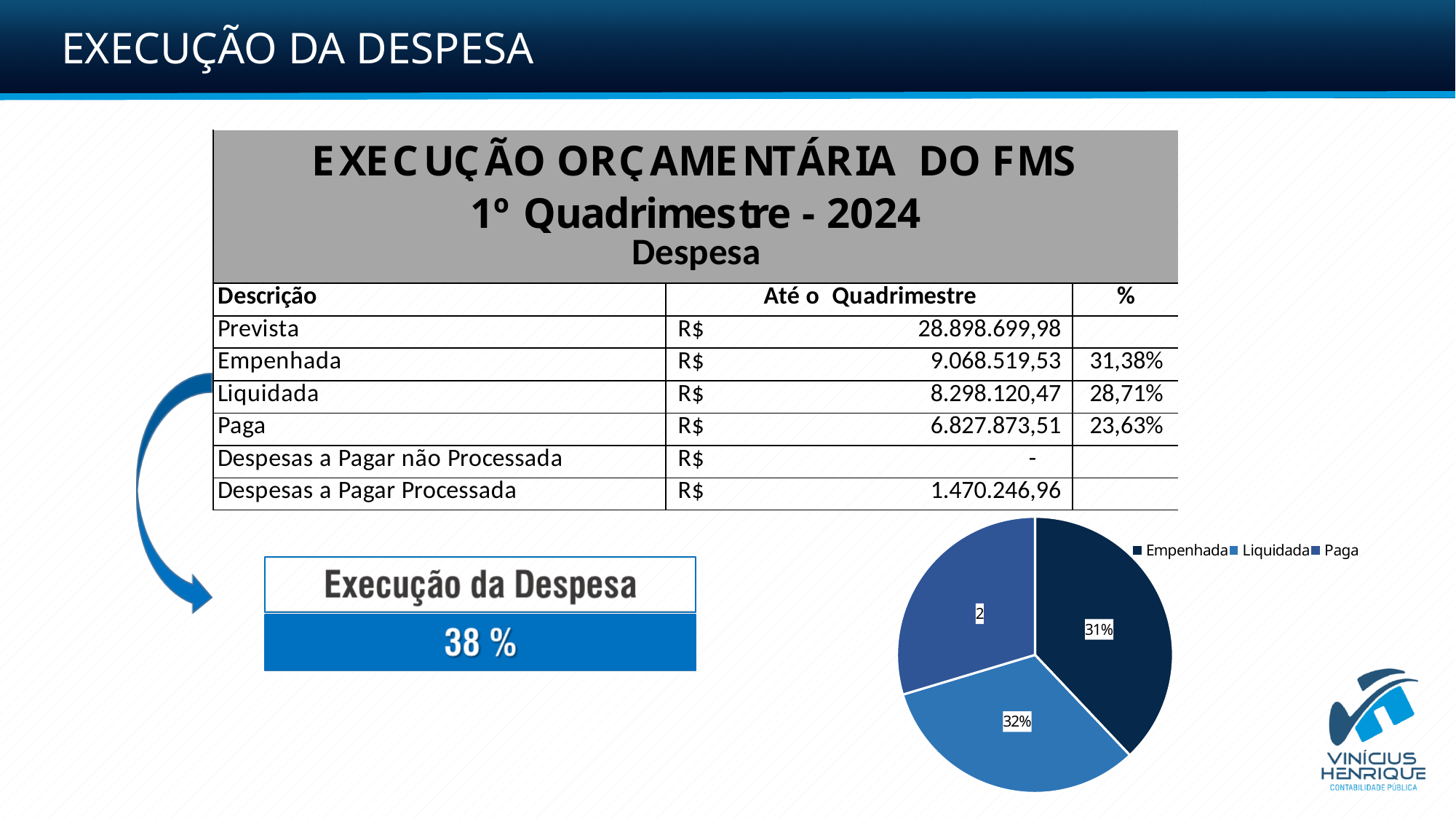
In the pie chart, what percentage is shown for the Empenhada slice? 31% How many entries does the pie chart's legend list? 3 How many slices does the pie chart have? 3 In the pie chart, which slice is coloured dark navy blue? Empenhada In the pie chart, what percentage is shown for the Liquidada slice? 32% What kind of chart is shown at the bottom right of the slide? Pie chart What are the legend entries of the pie chart, in order? Empenhada, Liquidada, Paga